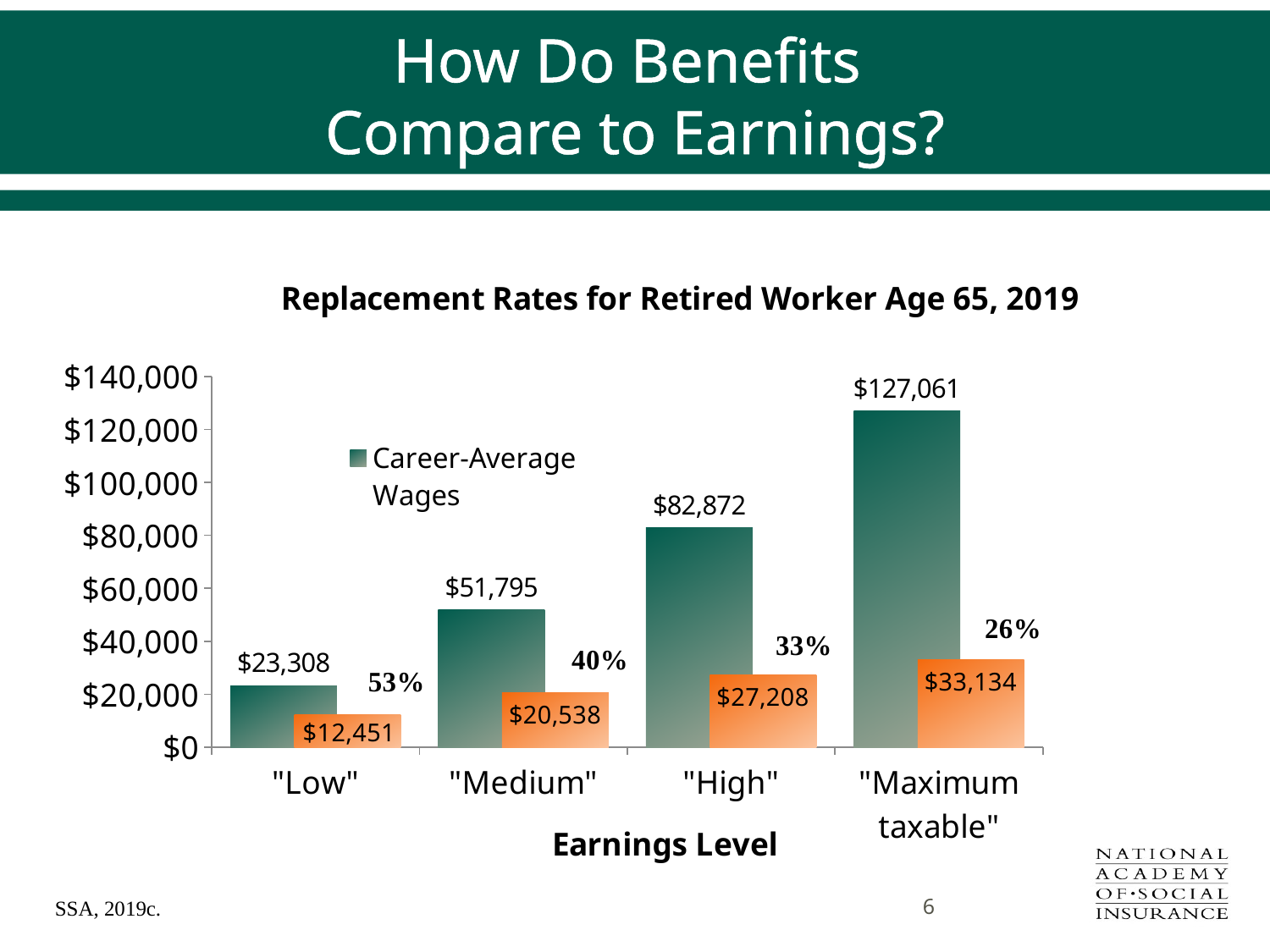
What is the difference between the Career-Average Wages and the orange bar value for "Maximum taxable"? $93,927 What is the value shown on the orange bar for the "High" earnings level? $27,208 How many earnings levels are shown on the x axis? 4 What kind of chart is shown on the slide? Bar chart Which earnings level has the lowest value on its orange bar? "Low" Is the Career-Average Wages value for "High" greater or less than $80,000? greater What is the title of the chart? Replacement Rates for Retired Worker Age 65, 2019 What percentage is shown above the orange bar for the "Low" earnings level? 53% Which earnings level has the highest Career-Average Wages? "Maximum taxable" What is the difference between the Career-Average Wages for "High" and "Medium"? $31,077 Which is larger: the orange bar for "Maximum taxable" or the Career-Average Wages bar for "Low"? The orange bar for "Maximum taxable" What is the Career-Average Wages value for the "Medium" earnings level? $51,795